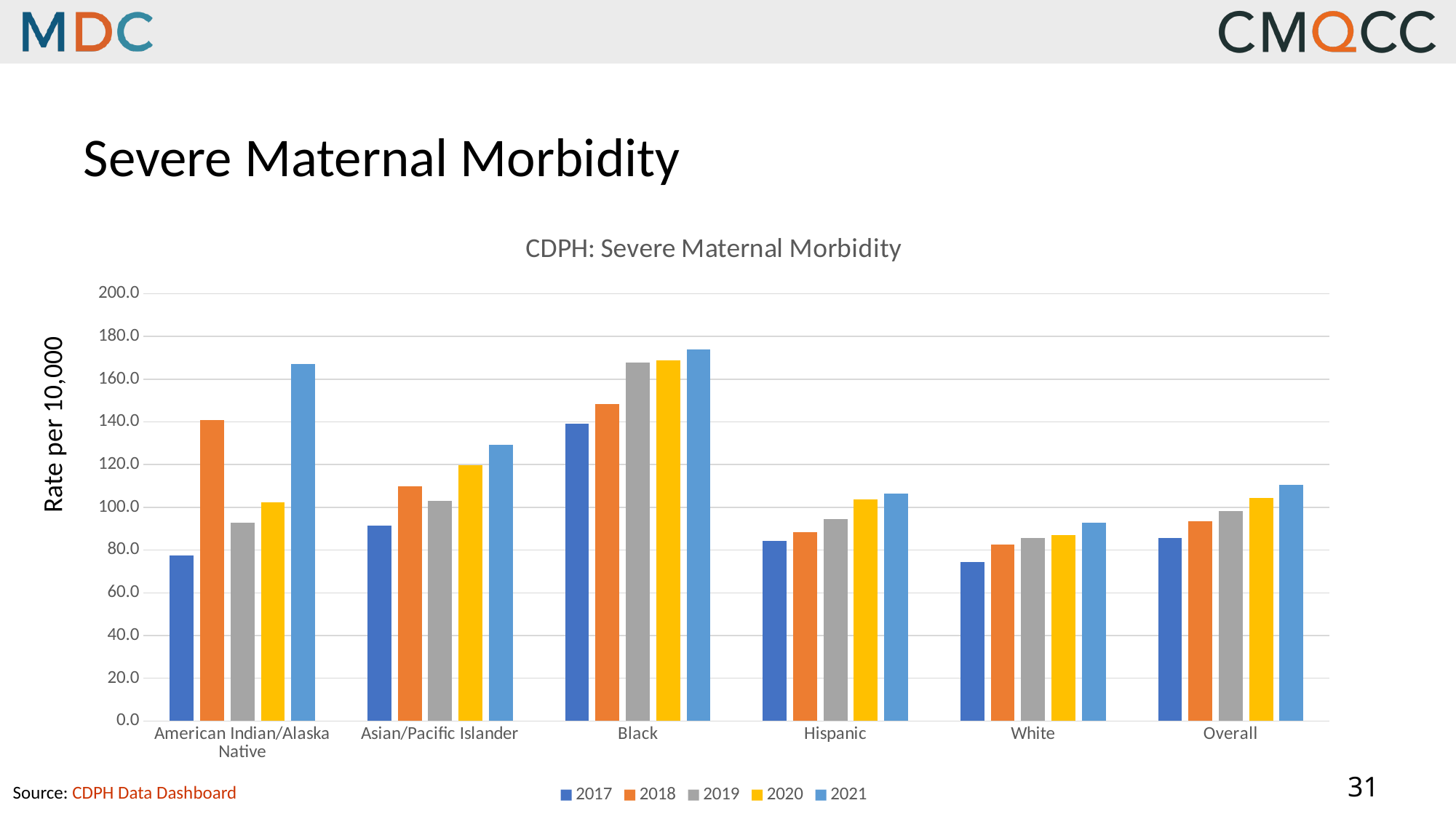
How many series does the legend list? 5 What is the title of the chart? CDPH: Severe Maternal Morbidity What is the label on the vertical axis? Rate per 10,000 Is the 2017 value for White greater or less than 80? less Is the 2021 value for Black greater or less than 160? greater Do the values for Black rise or fall from 2017 to 2021? rise For American Indian/Alaska Native, which is larger: the 2018 value or the 2019 value? 2018 Is the 2021 value for Hispanic greater or less than 100? greater Which category has the highest value for 2021? Black How many categories are shown along the x axis? 6 Which category has the lowest value for 2017? White What kind of chart is shown on the slide? Bar chart